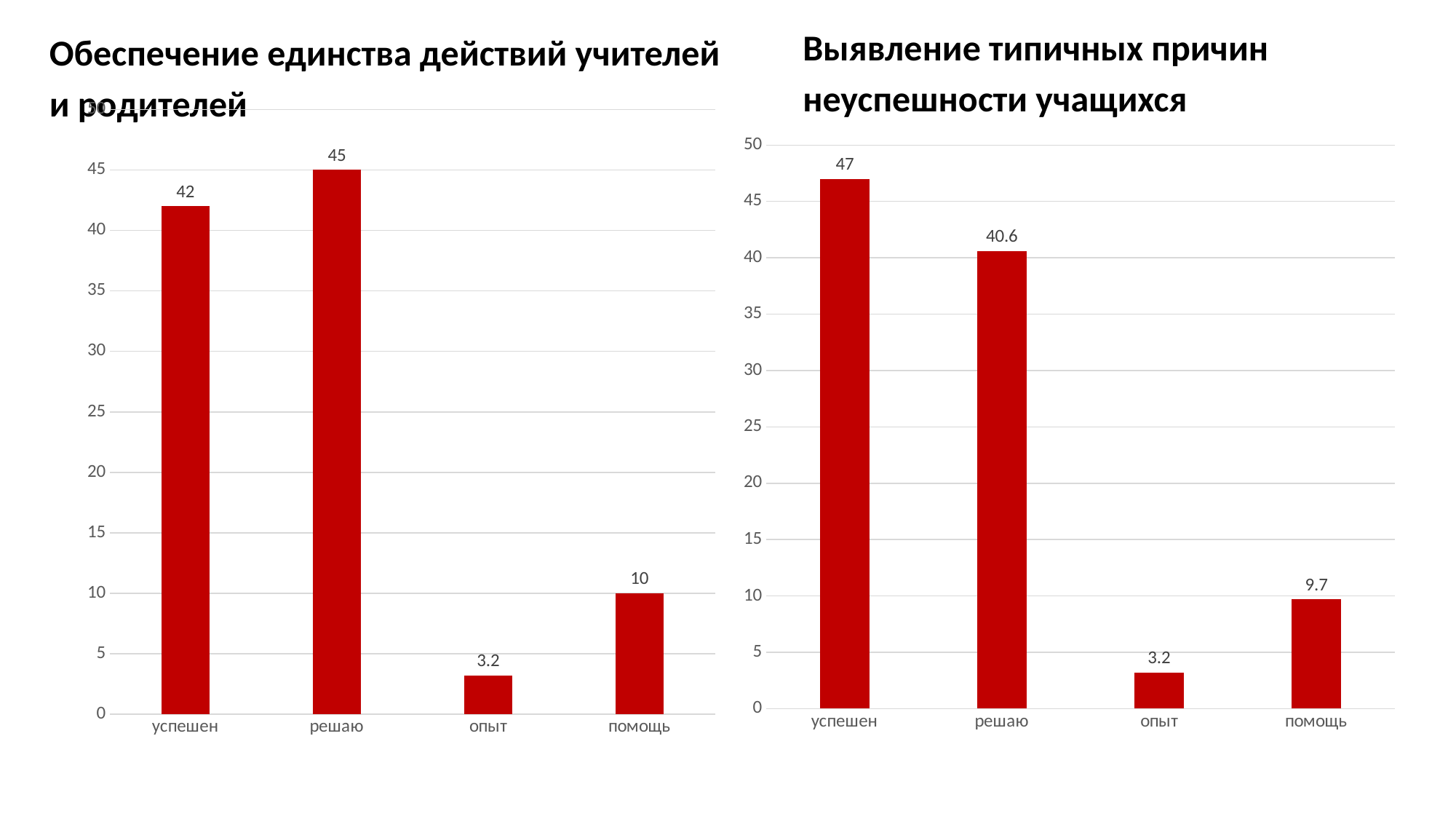
In the right chart (Выявление типичных причин неуспешности учащихся), what is the difference between the values for успешен and решаю? 6.4 In the left chart (Обеспечение единства действий учителей и родителей), what is the value for опыт? 3.2 In the left chart (Обеспечение единства действий учителей и родителей), what is the difference between the values for помощь and опыт? 6.8 In the left chart (Обеспечение единства действий учителей и родителей), is the value for помощь greater or less than 15? less How many categories are shown in the right chart (Выявление типичных причин неуспешности учащихся)? 4 In the right chart (Выявление типичных причин неуспешности учащихся), what is the value for решаю? 40.6 In the right chart (Выявление типичных причин неуспешности учащихся), which category has the lowest value? опыт Which is larger: the value for успешен in the left chart or the value for успешен in the right chart? the right chart (47) What type of chart is the left chart (Обеспечение единства действий учителей и родителей)? bar chart In the left chart (Обеспечение единства действий учителей и родителей), what is the value for решаю? 45 In the left chart (Обеспечение единства действий учителей и родителей), which category has the highest value? решаю In the right chart (Выявление типичных причин неуспешности учащихся), what is the value for помощь? 9.7